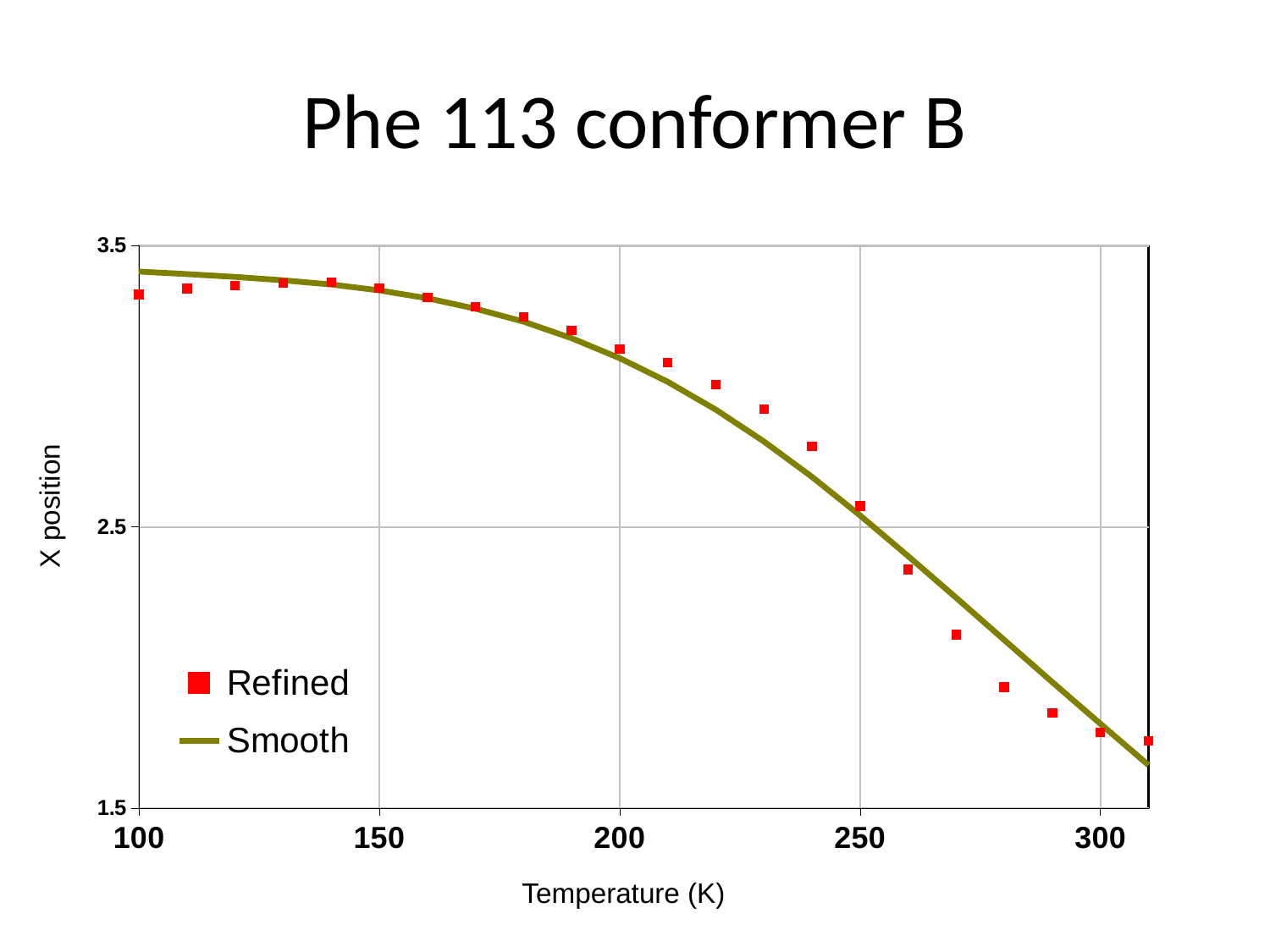
Is the Refined value at 240 K greater or less than 2.5? greater Is the Refined value at 300 K greater or less than 2.5? less Is the Refined value at 100 K greater or less than 2.5? greater What kind of chart is shown on the slide? scatter chart with a fitted line What are the names of the two series in the legend? Refined and Smooth What is the title of the chart? Phe 113 conformer B Which has the larger Refined value, 200 K or 300 K? 200 K How many Refined data points are plotted? 22 How many series does the legend list? 2 What is the label of the x axis? Temperature (K) Does the X position rise or fall as temperature increases along the x axis? fall